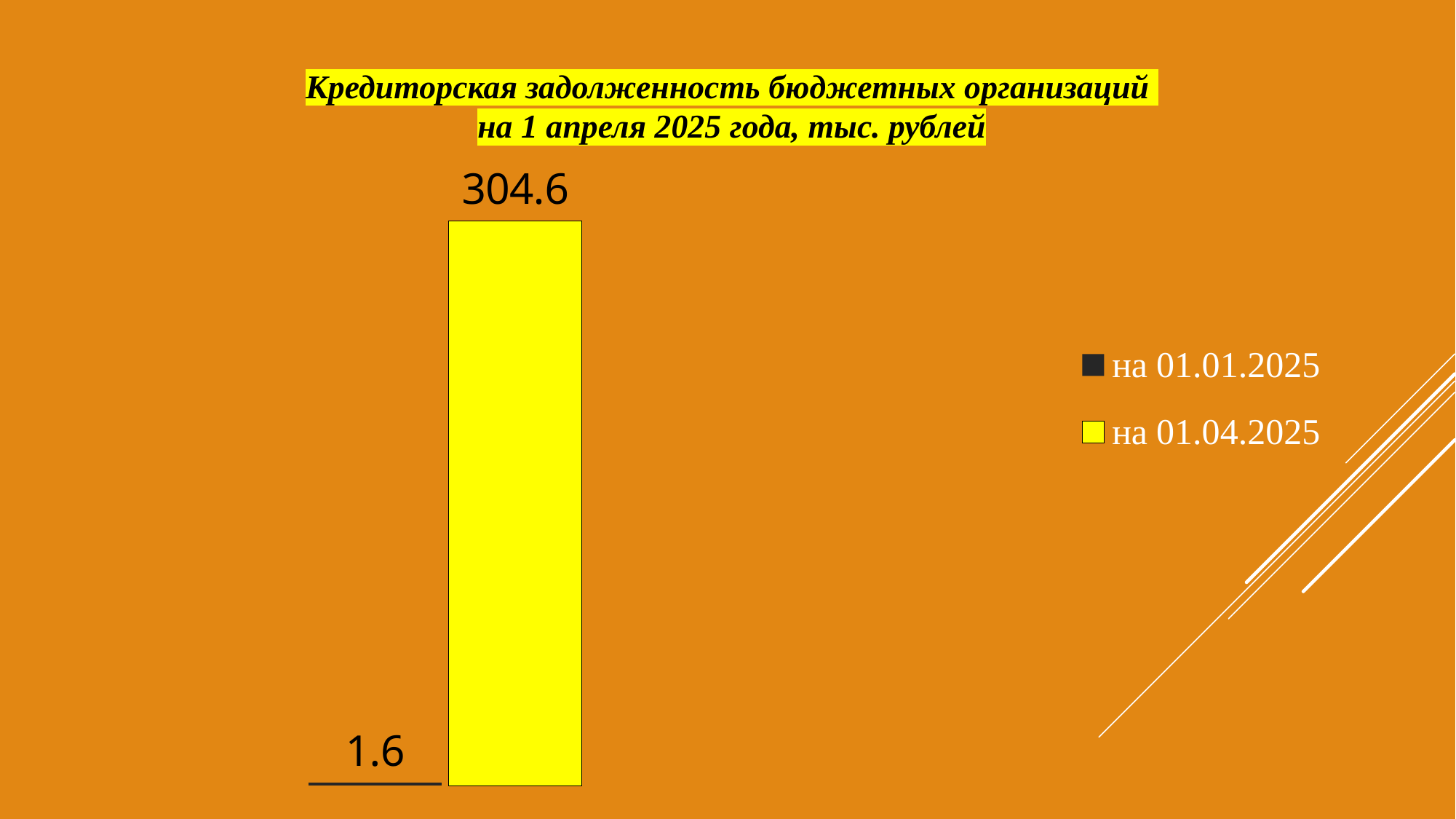
Which series has the lowest value? на 01.01.2025 What is the title of the chart? Кредиторская задолженность бюджетных организаций на 1 апреля 2025 года, тыс. рублей How many series does the legend list? 2 What colour is the bar for на 01.04.2025? yellow Did the value rise or fall from 01.01.2025 to 01.04.2025? rise How many bars are plotted on the chart? 2 What is the value for на 01.04.2025? 304.6 What is the difference between the values for на 01.04.2025 and на 01.01.2025? 303 Which series has the higher value, на 01.01.2025 or на 01.04.2025? на 01.04.2025 What is the value for на 01.01.2025? 1.6 What kind of chart is shown on the slide? bar chart